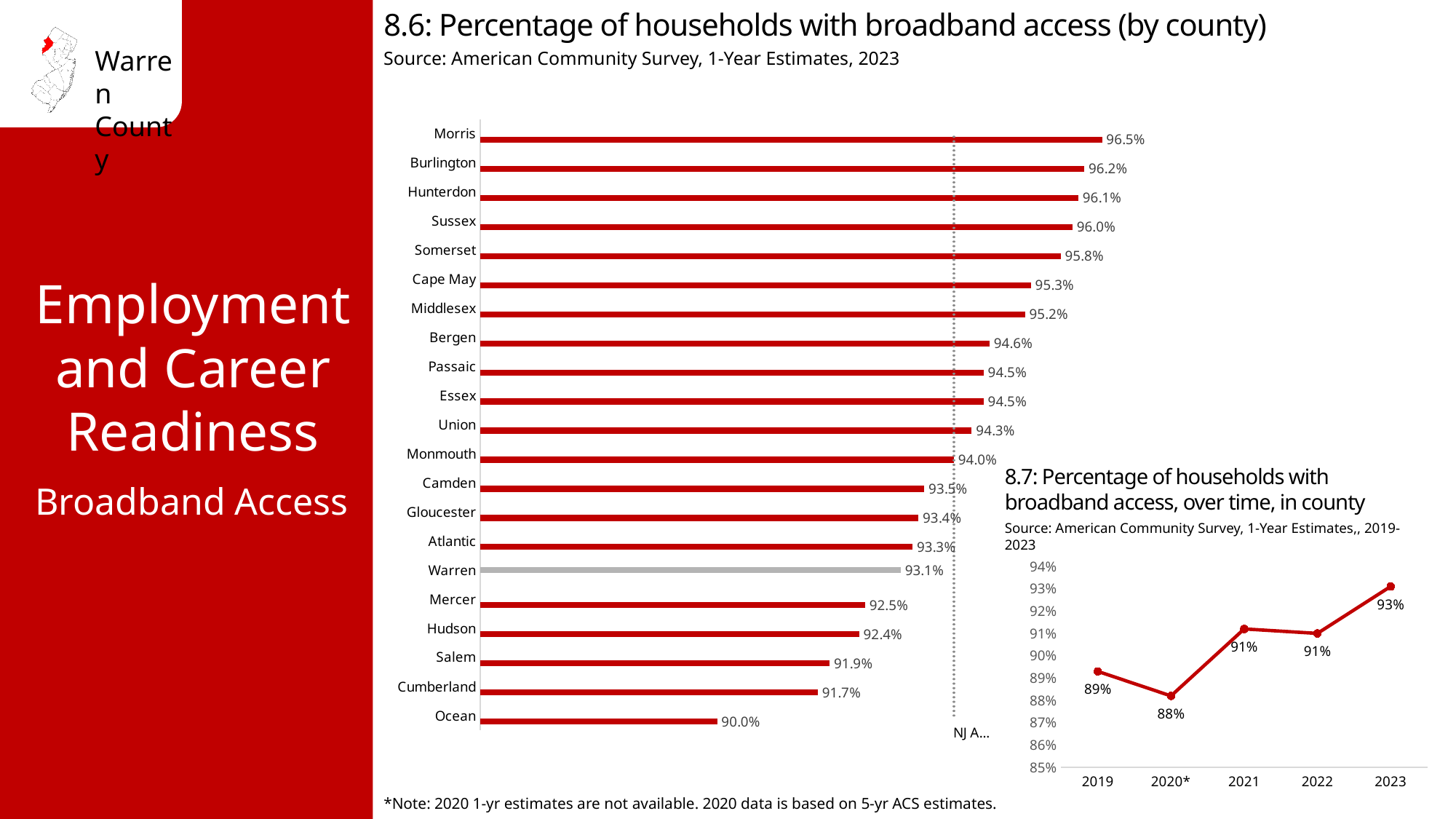
In chart 8.6, which has a higher value, Sussex or Cumberland? Sussex In chart 8.6, which county has the lowest percentage of households with broadband access? Ocean What kind of chart is chart 8.6? Bar chart In chart 8.6, how many counties are shown? 21 What kind of chart is chart 8.7? Line chart In chart 8.7, how many data points are plotted? 5 In chart 8.6 (percentage of households with broadband access by county), what is the value for Warren? 93.1% In chart 8.6, what is the value for Hunterdon? 96.1% In chart 8.7 (percentage of households with broadband access over time), what is the value for 2023? 93% In chart 8.7, which year has the lowest value? 2020* In chart 8.6, which county has the highest percentage of households with broadband access? Morris In chart 8.6, what is the difference between the values for Morris and Ocean? 6.5 percentage points